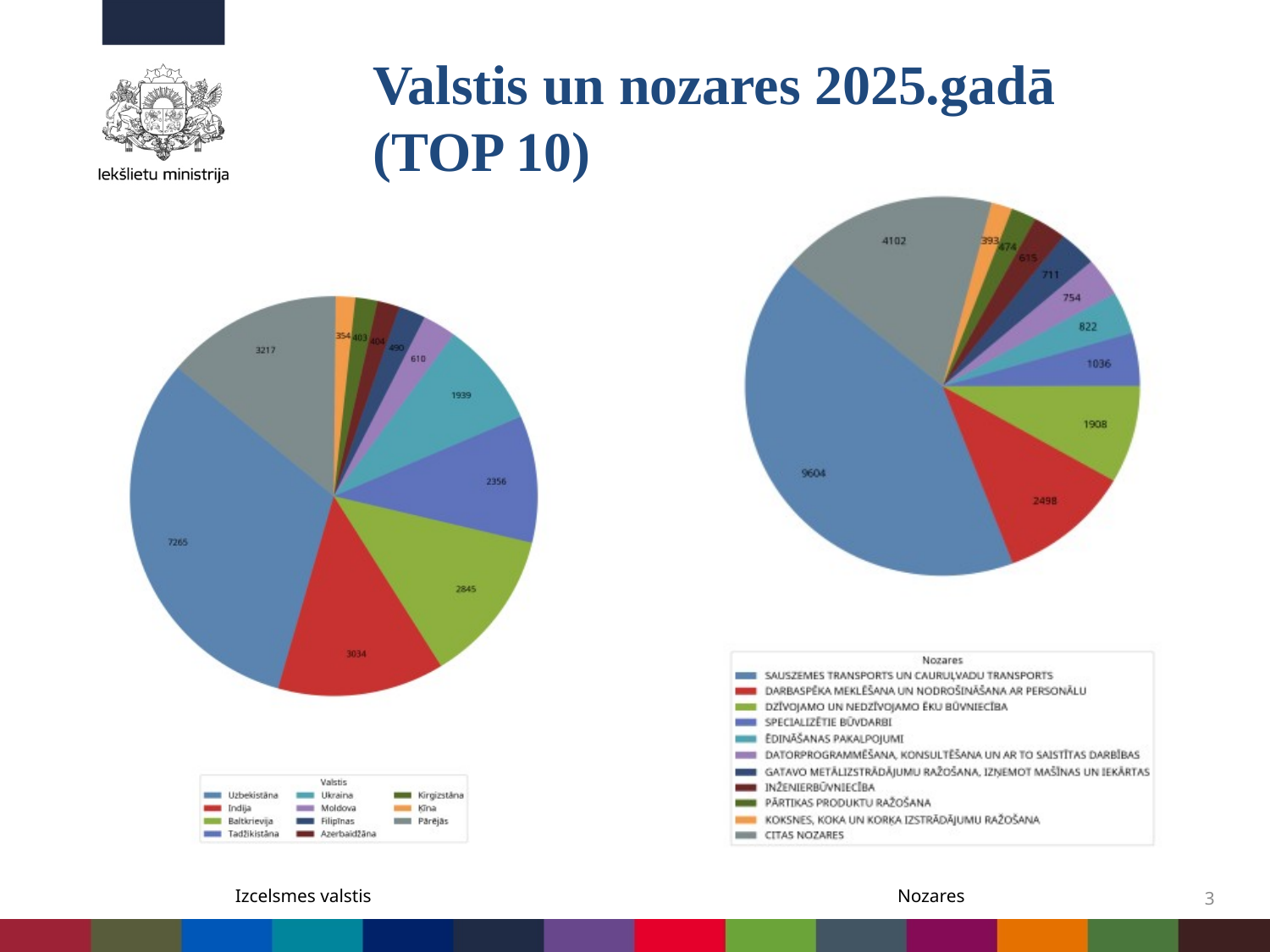
In the right chart (Nozares), which sector has the smallest slice? KOKSNES, KOKA UN KORKA IZSTRĀDĀJUMU RAŽOŠANA In the right chart (Nozares), what is the value for CITAS NOZARES? 4102 In the left chart (Izcelsmes valstis), what is the difference between the values for Indija and Baltkrievija? 189 In the left chart (Izcelsmes valstis), which country has the largest slice? Uzbekistāna How many entries does the legend of the left chart (Valstis) list? 11 What kind of chart is the left chart (Izcelsmes valstis)? Pie chart In the right chart (Nozares), what is the value for SAUSZEMES TRANSPORTS UN CAURUĻVADU TRANSPORTS? 9604 In the right chart (Nozares), what is the difference between the values for DARBASPĒKA MEKLĒŠANA UN NODROŠINĀŠANA AR PERSONĀLU and DZĪVOJAMO UN NEDZĪVOJAMO ĒKU BŪVNIECĪBA? 590 What is the title of the slide? Valstis un nozares 2025.gadā (TOP 10) In the left chart (Izcelsmes valstis), which is larger, the value for Tadžikistāna or the value for Ukraina? Tadžikistāna In the left chart (Izcelsmes valstis), what is the value for Indija? 3034 In the left chart (Izcelsmes valstis), what is the value for Uzbekistāna? 7265